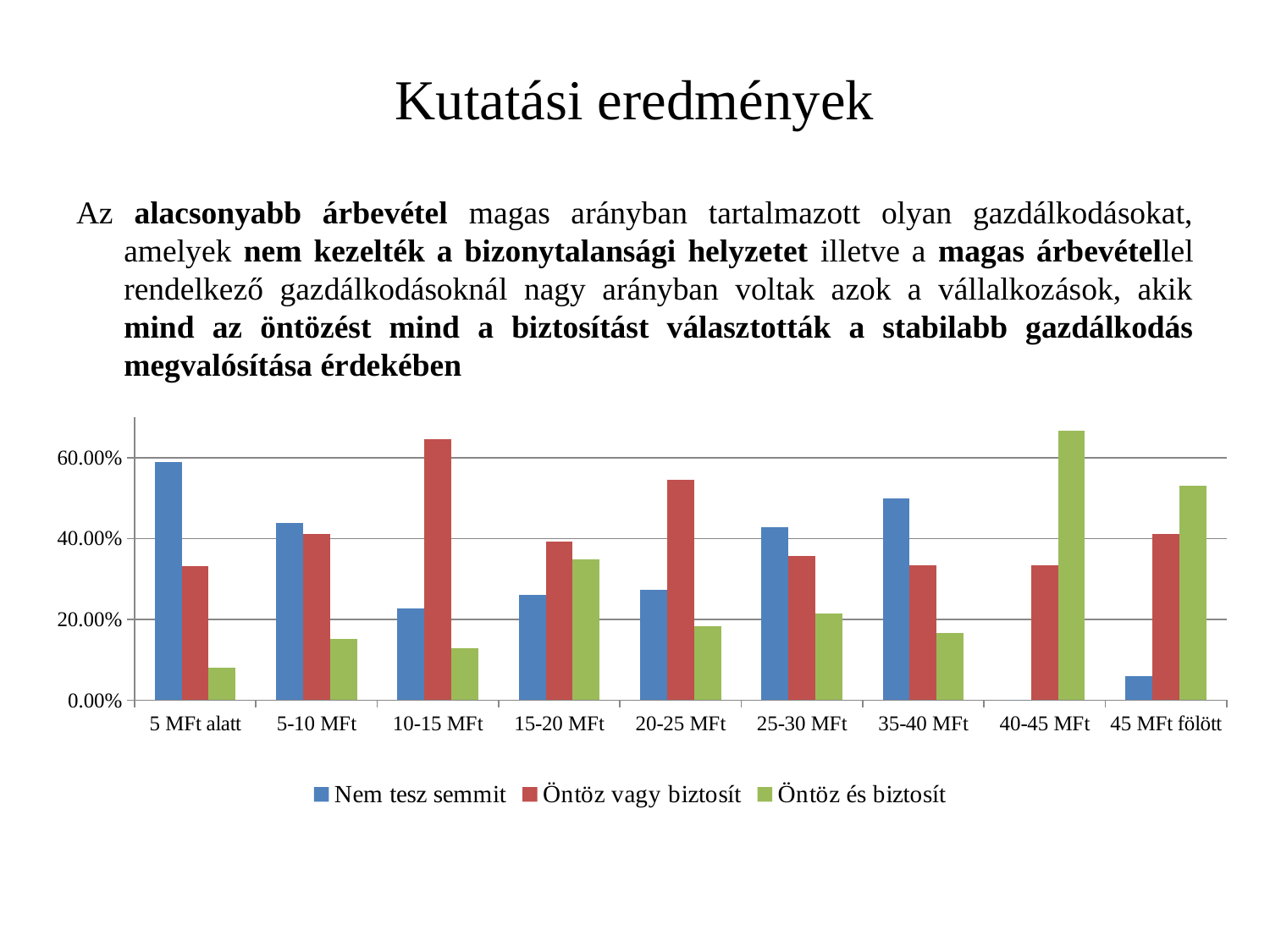
Which series is shown in green in the chart? Öntöz és biztosít For which category is the 'Öntöz és biztosít' value lowest? 5 MFt alatt For 10-15 MFt, which is larger: 'Nem tesz semmit' or 'Öntöz vagy biztosít'? Öntöz vagy biztosít How many revenue categories are shown on the x axis of the chart? 9 How many series does the chart's legend list? 3 Is the 'Nem tesz semmit' value for 45 MFt fölött greater or less than 20.00%? less For which category is the 'Öntöz és biztosít' value highest? 40-45 MFt Is the 'Öntöz és biztosít' value for 40-45 MFt greater or less than 60.00%? greater For which category is the 'Öntöz vagy biztosít' value highest? 10-15 MFt For which category is the 'Nem tesz semmit' value highest? 5 MFt alatt Is the 'Nem tesz semmit' value for 5 MFt alatt greater or less than 40.00%? greater What kind of chart is shown on the slide? bar chart